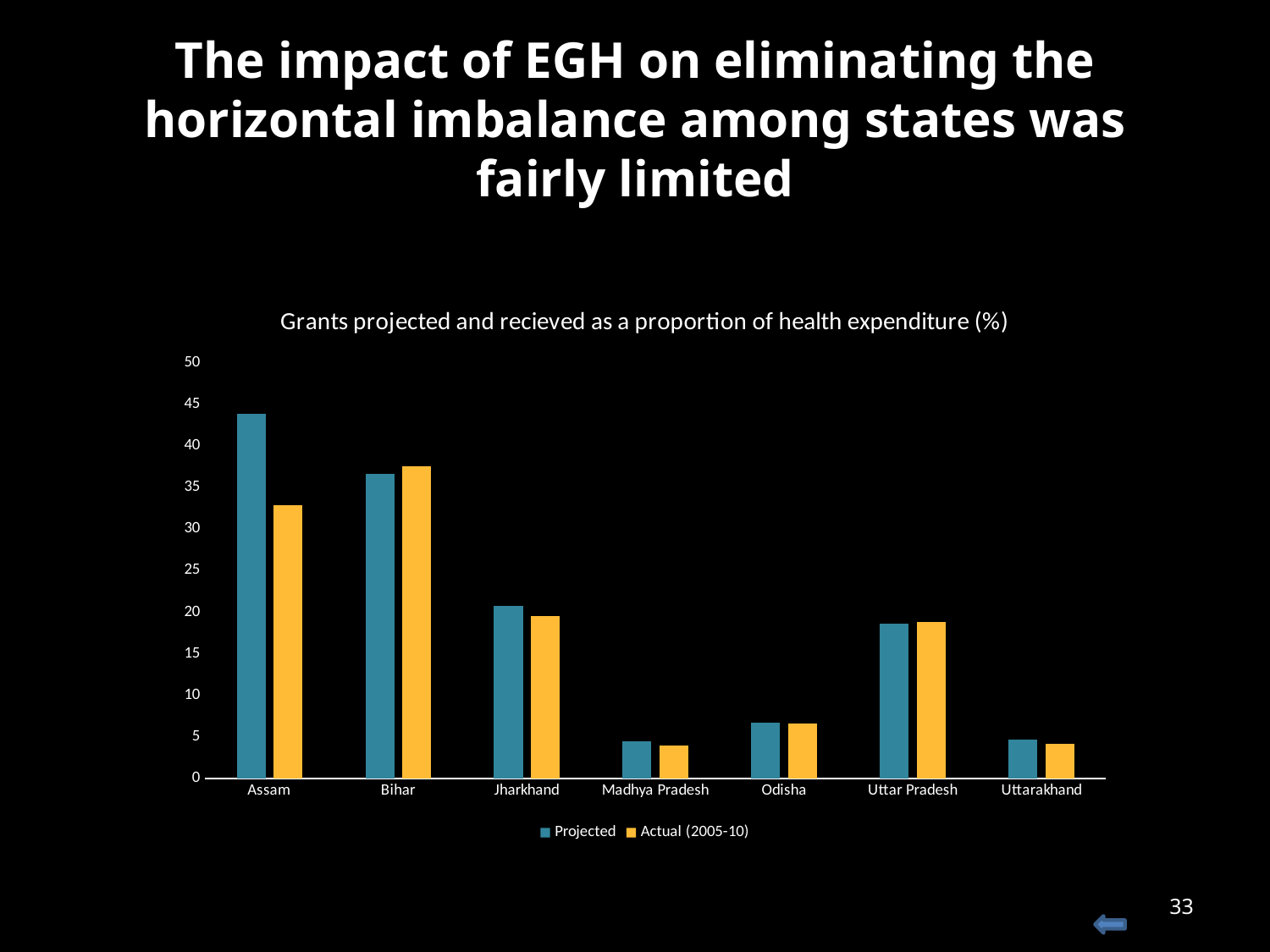
Is the Actual (2005-10) value for Assam greater or less than 30? greater How many series does the chart's legend list? 2 Is the Actual (2005-10) value for Uttar Pradesh greater or less than 20? less Which state has the highest Actual (2005-10) value? Bihar What kind of chart is shown on the slide? bar chart For Assam, which is larger: the Projected value or the Actual (2005-10) value? Projected How many states are shown on the x axis of the chart? 7 Which is larger: the Actual (2005-10) value for Assam or the Actual (2005-10) value for Bihar? Bihar What is the title of the chart? Grants projected and recieved as a proportion of health expenditure (%) Is the Projected value for Assam greater or less than 40? greater Which state has the highest Projected value? Assam